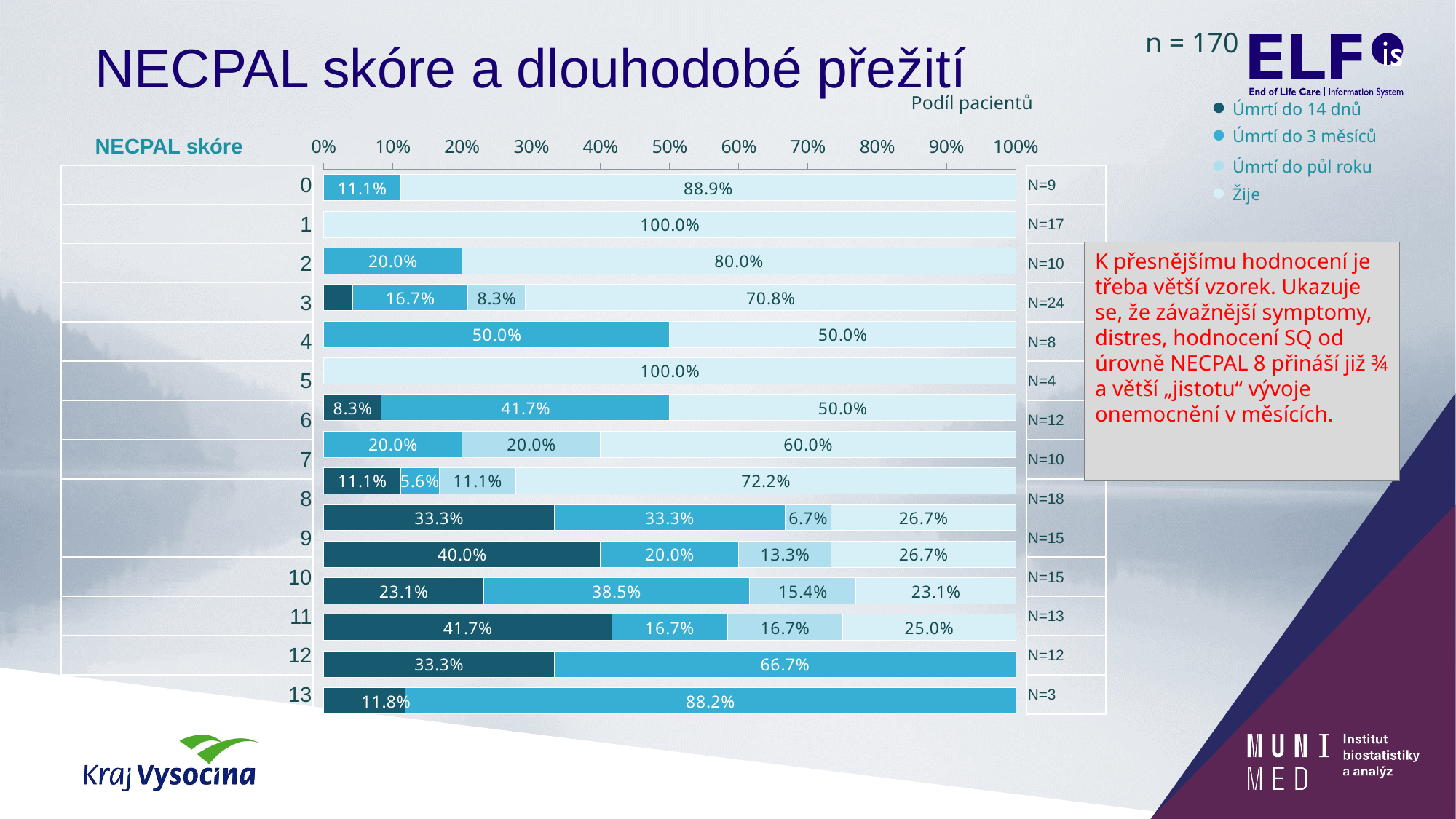
What is the share of 'Žije' for NECPAL score 2? 80.0% What kind of chart is shown on the slide? Stacked bar chart Which has the larger 'Úmrtí do 3 měsíců' share: NECPAL score 6 or NECPAL score 2? NECPAL score 6 What total sample size (n) is stated on the slide? n = 170 How many series does the legend list? 4 What is the first entry in the chart legend? Úmrtí do 14 dnů What is the share of 'Úmrtí do půl roku' for NECPAL score 3? 8.3% What is the share of 'Žije' for NECPAL score 0? 88.9% What is the N shown for NECPAL score 3? N=24 What is the difference between the 'Žije' share for NECPAL score 0 and for NECPAL score 4? 38.9 percentage points What is the share of 'Úmrtí do 3 měsíců' for NECPAL score 4? 50.0% What is the share of 'Úmrtí do 14 dnů' for NECPAL score 6? 8.3%